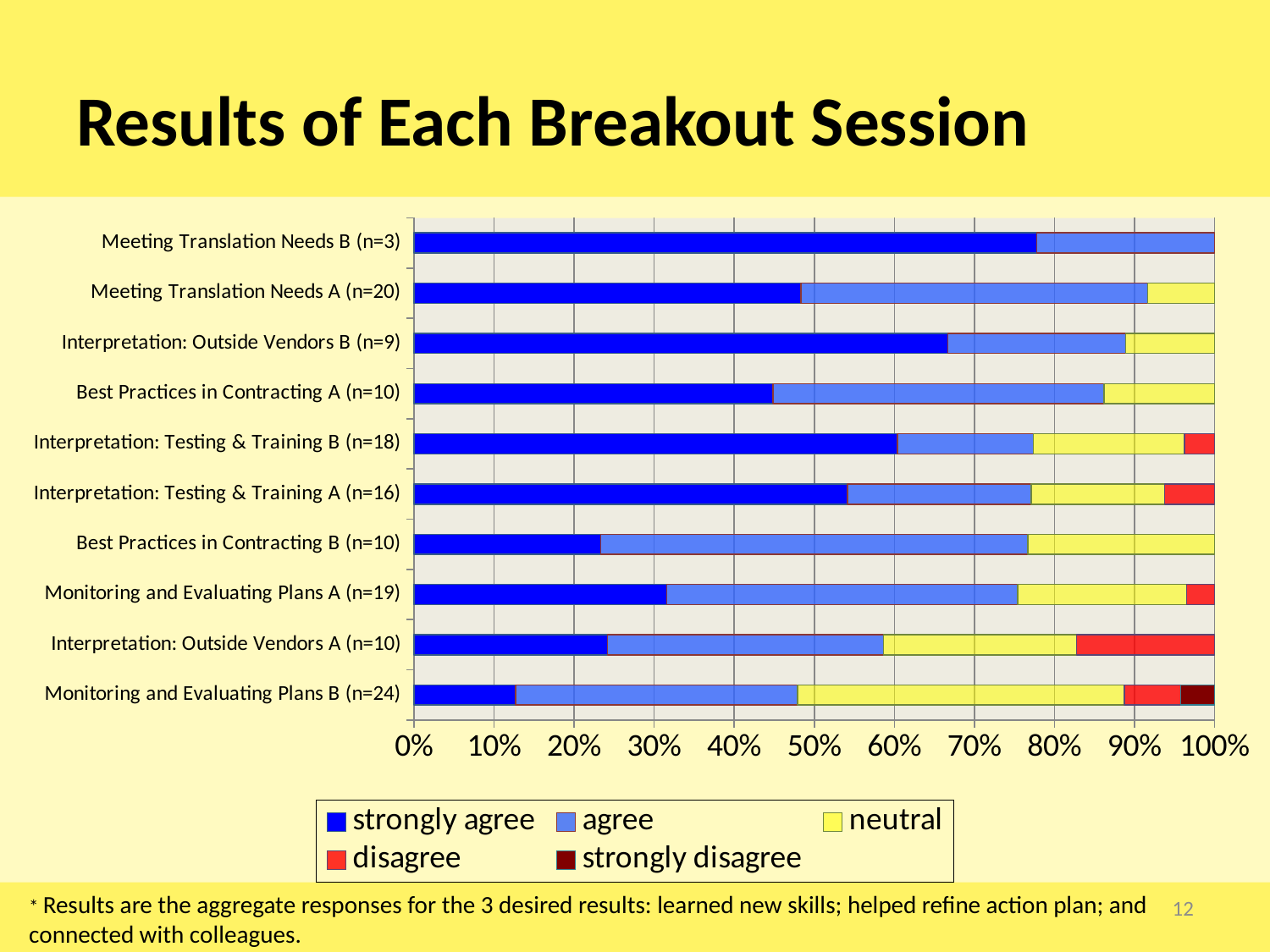
How many series does the chart legend list? 5 Which category has the largest 'strongly agree' share? Meeting Translation Needs B (n=3) Is the 'strongly agree' share for Best Practices in Contracting B (n=10) greater or less than 30%? less Which category is the only one with a 'strongly disagree' segment? Monitoring and Evaluating Plans B (n=24) How many breakout session categories are plotted on the chart? 10 Which has the larger 'strongly agree' share: Interpretation: Outside Vendors B (n=9) or Best Practices in Contracting A (n=10)? Interpretation: Outside Vendors B (n=9) What kind of chart is shown on the slide? Stacked bar chart Is the 'strongly agree' share for Interpretation: Outside Vendors B (n=9) greater or less than 60%? greater What colour represents the 'neutral' series in the legend? Yellow Is the 'strongly agree' share for Meeting Translation Needs B (n=3) greater or less than 70%? greater Which category has the smallest 'strongly agree' share? Monitoring and Evaluating Plans B (n=24)